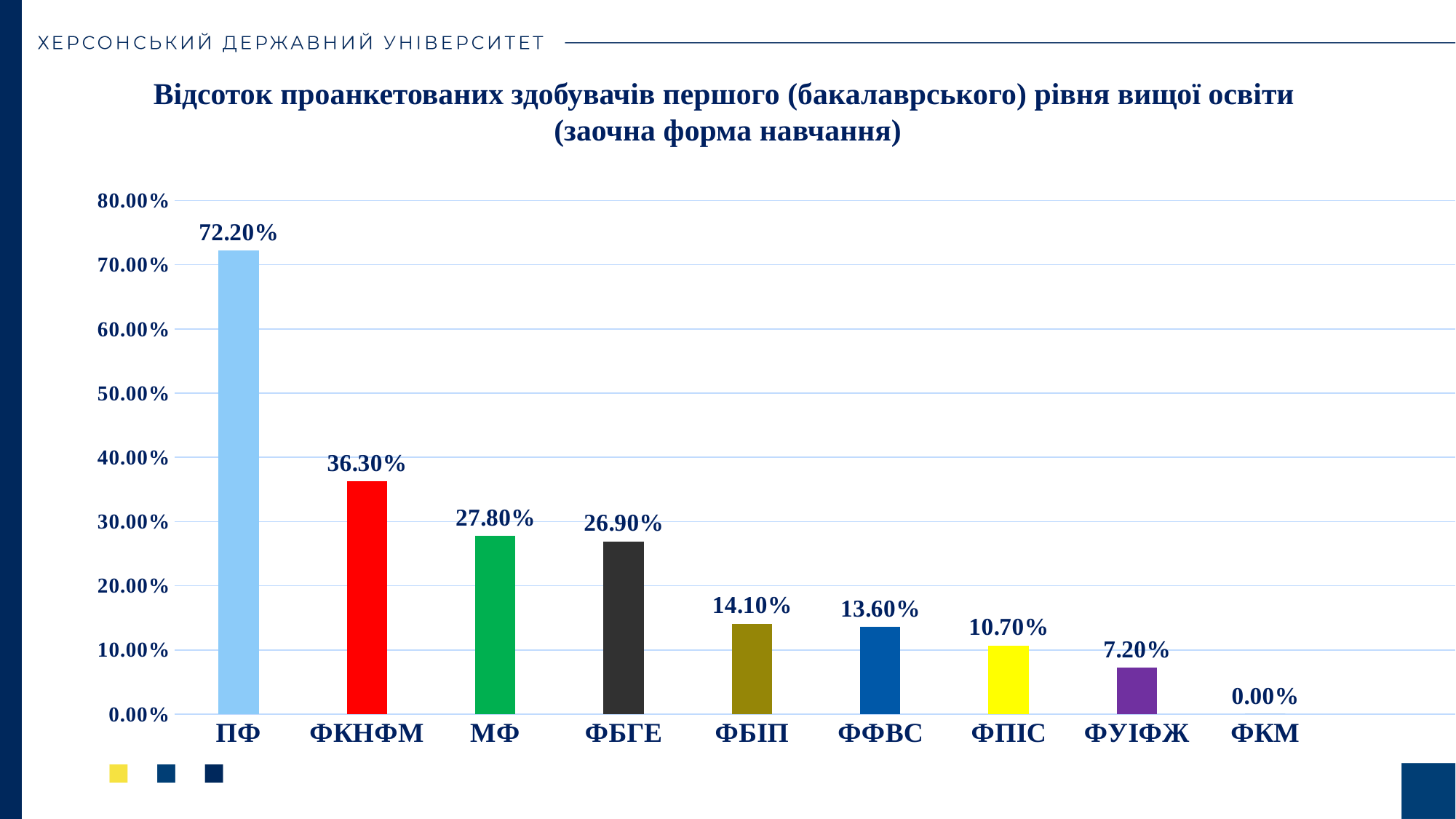
What kind of chart is shown on the slide? bar chart Which is larger, the value for ФФВС or the value for ФПІС? ФФВС How many categories are shown on the x axis? 9 What is the value for ФБІП? 14.10% What is the value for ФУІФЖ? 7.20% Which category has the lowest value? ФКМ What is the value for ФКНФМ? 36.30% Which category has the highest value? ПФ Do the values rise or fall from left to right along the x axis? fall What is the difference between the values for ПФ and ФКНФМ? 35.90% What is the difference between the values for МФ and ФБГЕ? 0.90% What is the value for ПФ? 72.20%